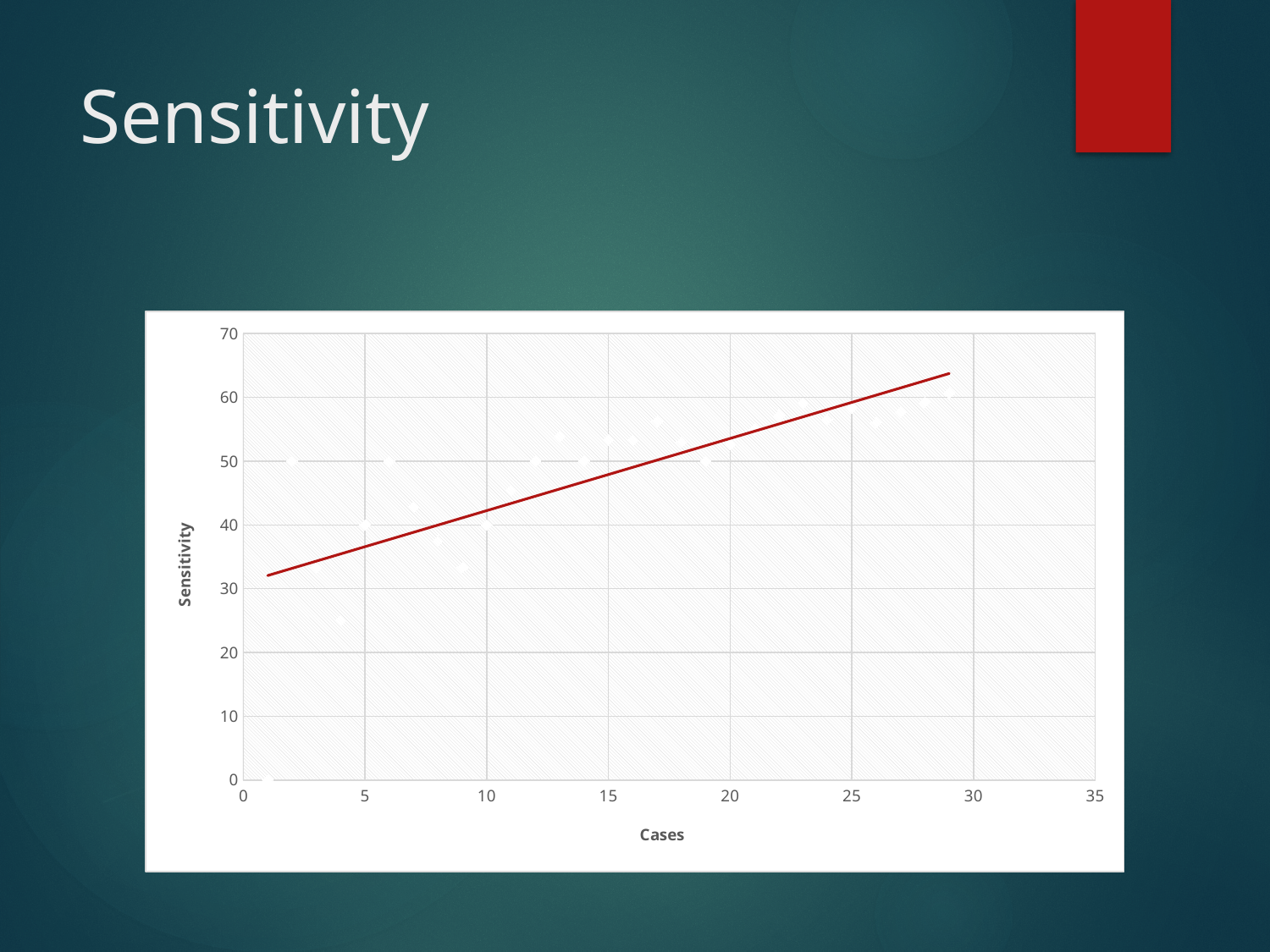
Is the value of the red trend line at 1 case greater or less than 40? less Is the value of the red trend line at 29 cases greater or less than 60? greater Does the red trend line rise or fall as Cases increases? rises Is the plotted point at 4 cases greater or less than 30 on the Sensitivity axis? less What is the label of the x axis? Cases What kind of chart is shown on the slide? scatter chart What is the label of the y axis? Sensitivity What is the highest value shown on the y axis? 70